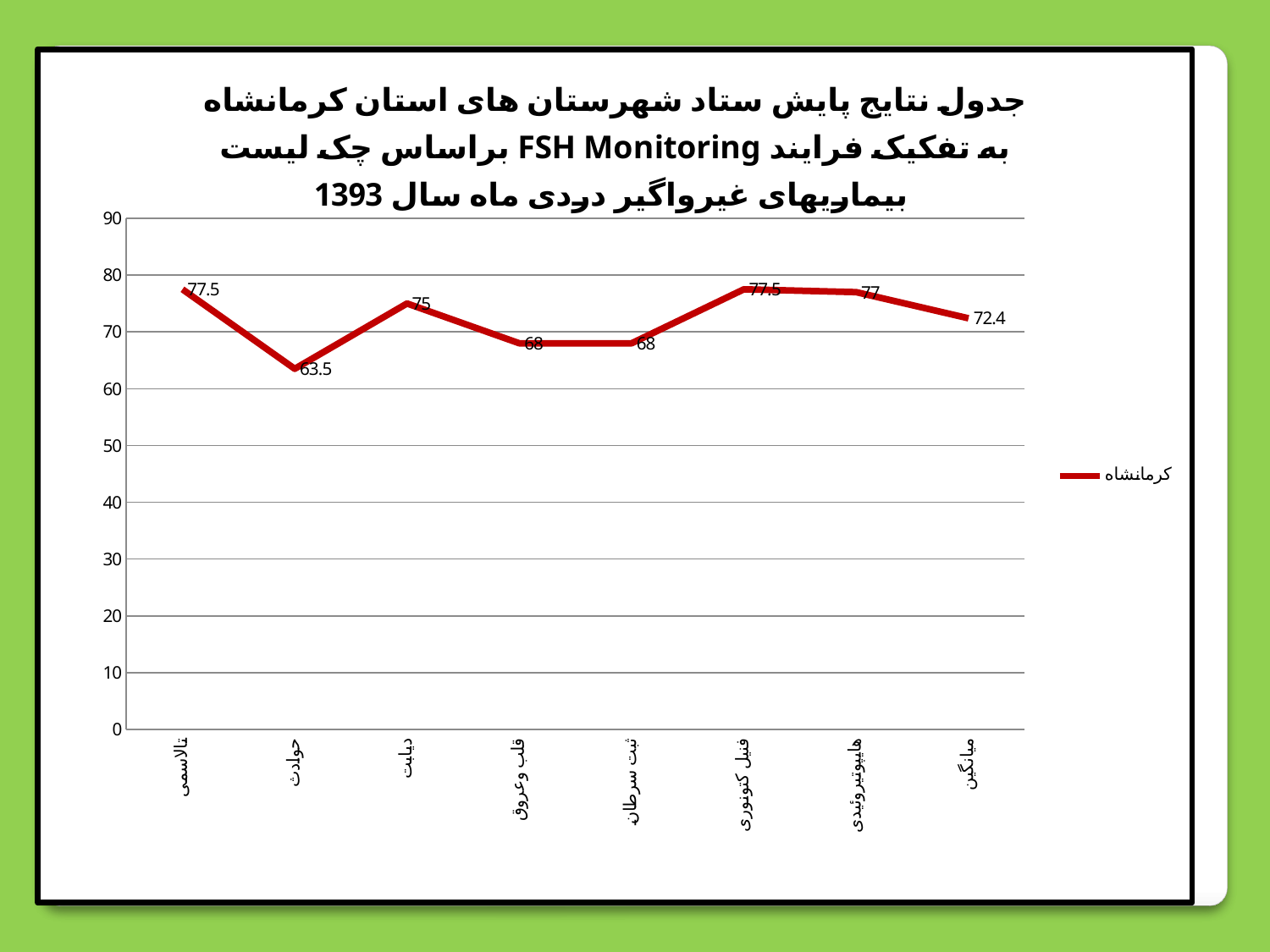
What is the value for هایپوتیروئیدی? 77 What is the name of the series shown in the legend? کرمانشاه Is the value for ثبت سرطان greater or less than 70? less What is the difference between the values for تالاسمی and حوادث? 14 Which is larger, the value for دیابت or the value for قلب وعروق? دیابت Which category has the lowest value? حوادث How many series does the legend list? 1 How many categories are plotted on the x axis? 8 What is the value for دیابت? 75 What is the value for میانگین? 72.4 What type of chart is shown on the slide? line chart What is the value for حوادث? 63.5